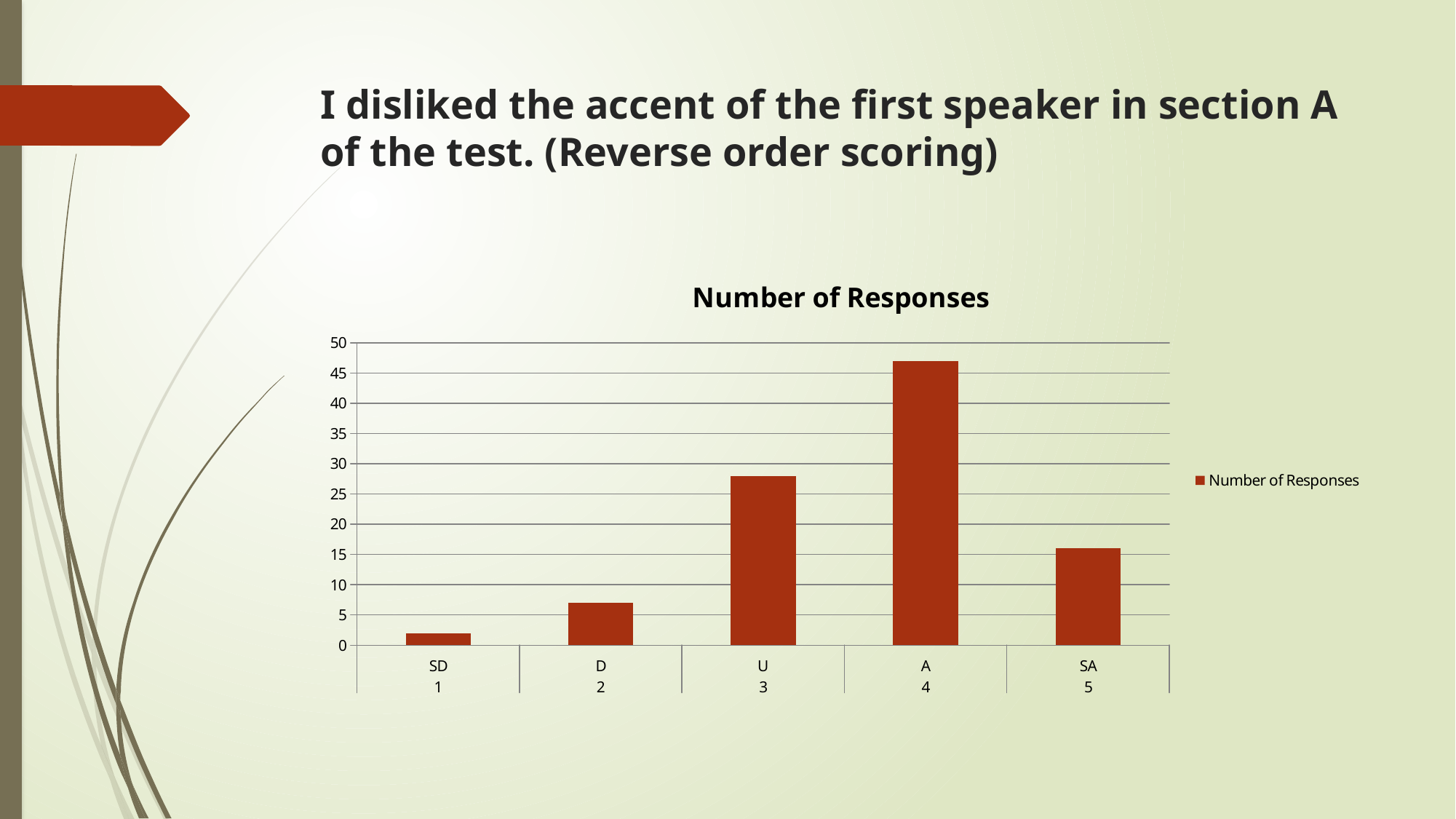
Which has more responses, U 3 or SA 5? U 3 Which category has the highest number of responses? A 4 How many categories are shown on the x axis of the chart? 5 Is the value for SD 1 greater or less than 5? less What type of chart is shown on the slide? bar chart What is the title of the chart? Number of Responses Is the value for A 4 greater or less than 45? greater Is the value for U 3 greater or less than 25? greater Which has more responses, D 2 or SD 1? D 2 How many series does the legend list? 1 Which category has the lowest number of responses? SD 1